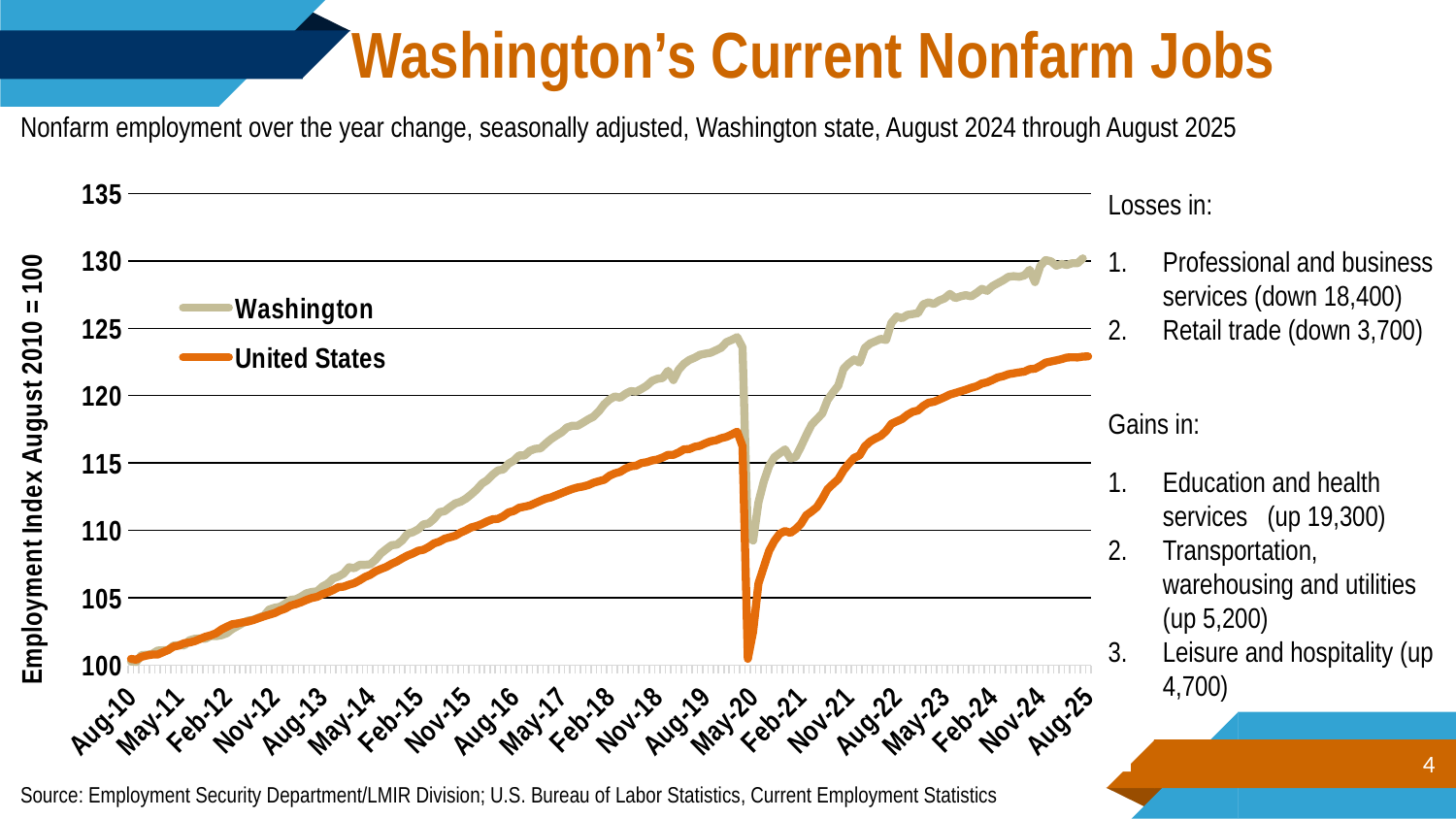
Is the value for Washington at Aug-19 greater or less than 120? greater At Aug-25, which series has the higher value, Washington or United States? Washington How many series does the legend list? 2 What is the title of the vertical axis? Employment Index August 2010 = 100 Is the value for United States at Aug-25 greater or less than 125? less Is the value for United States at its lowest point around May-20 greater or less than 105? less What kind of chart is shown on the slide? line chart Overall from Aug-10 to Aug-25, does the Washington line rise or fall? rise How many date labels are shown along the x axis? 21 Which two series are listed in the chart legend? Washington and United States